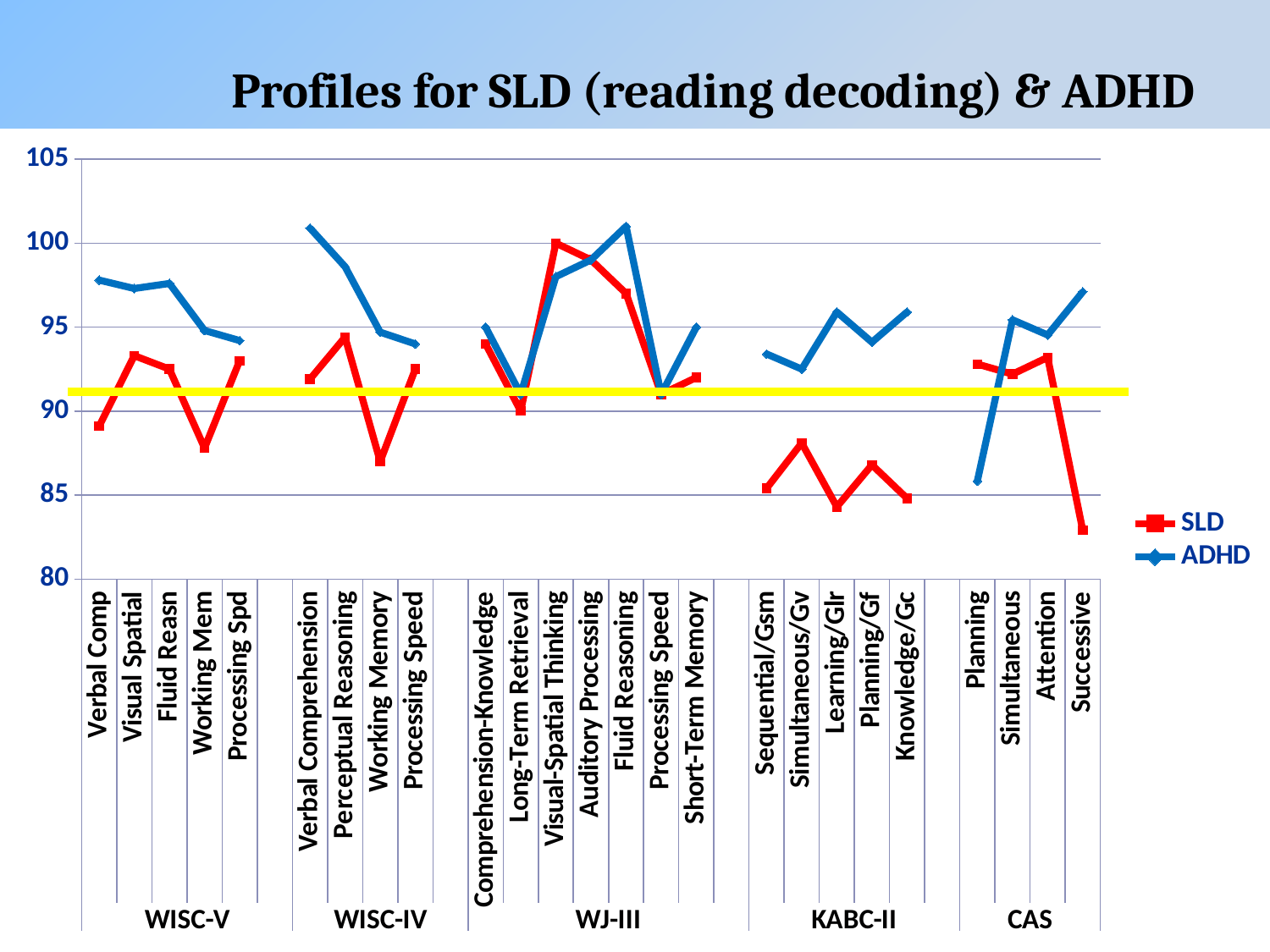
What is the title of the chart? Profiles for SLD (reading decoding) & ADHD Is the SLD value for Working Memory (WISC-IV) greater or less than 90? less How many categories are plotted under the WISC-V group? 5 Is the ADHD value for Verbal Comprehension (WISC-IV) greater or less than 100? greater What kind of chart is shown on the slide? Line chart Is the SLD value for Successive (CAS) greater or less than 85? less How many test groups are labelled along the x axis? 5 How many series does the legend list? 2 Which category has the lowest SLD value on the chart? Successive Which series has the higher value for Verbal Comp (WISC-V), SLD or ADHD? ADHD Which series has the higher value for Planning (CAS), SLD or ADHD? SLD What are the two series named in the legend? SLD and ADHD